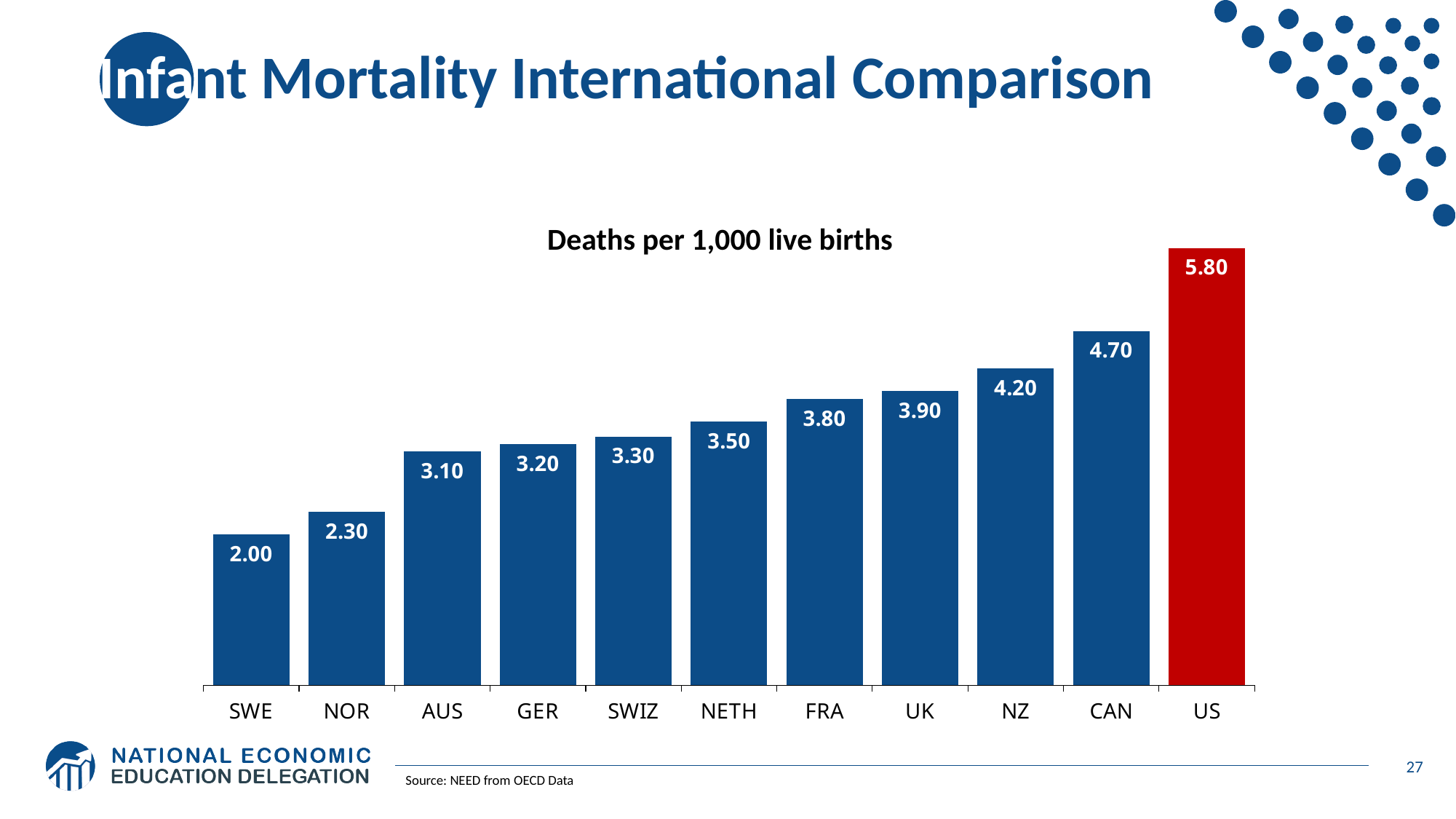
What is the difference between the values for the US and CAN? 1.10 What kind of chart is this? Bar chart What is the value for NETH? 3.50 Do the values rise or fall from left to right along the x axis? Rise How many countries are shown on the chart? 11 What is the value for the US? 5.80 What is the difference between the values for NZ and SWE? 2.20 What is the value for GER? 3.20 What is the title of the chart? Deaths per 1,000 live births Which country has the lowest value? SWE Which country has the highest value? US Which has a larger value, FRA or UK? UK